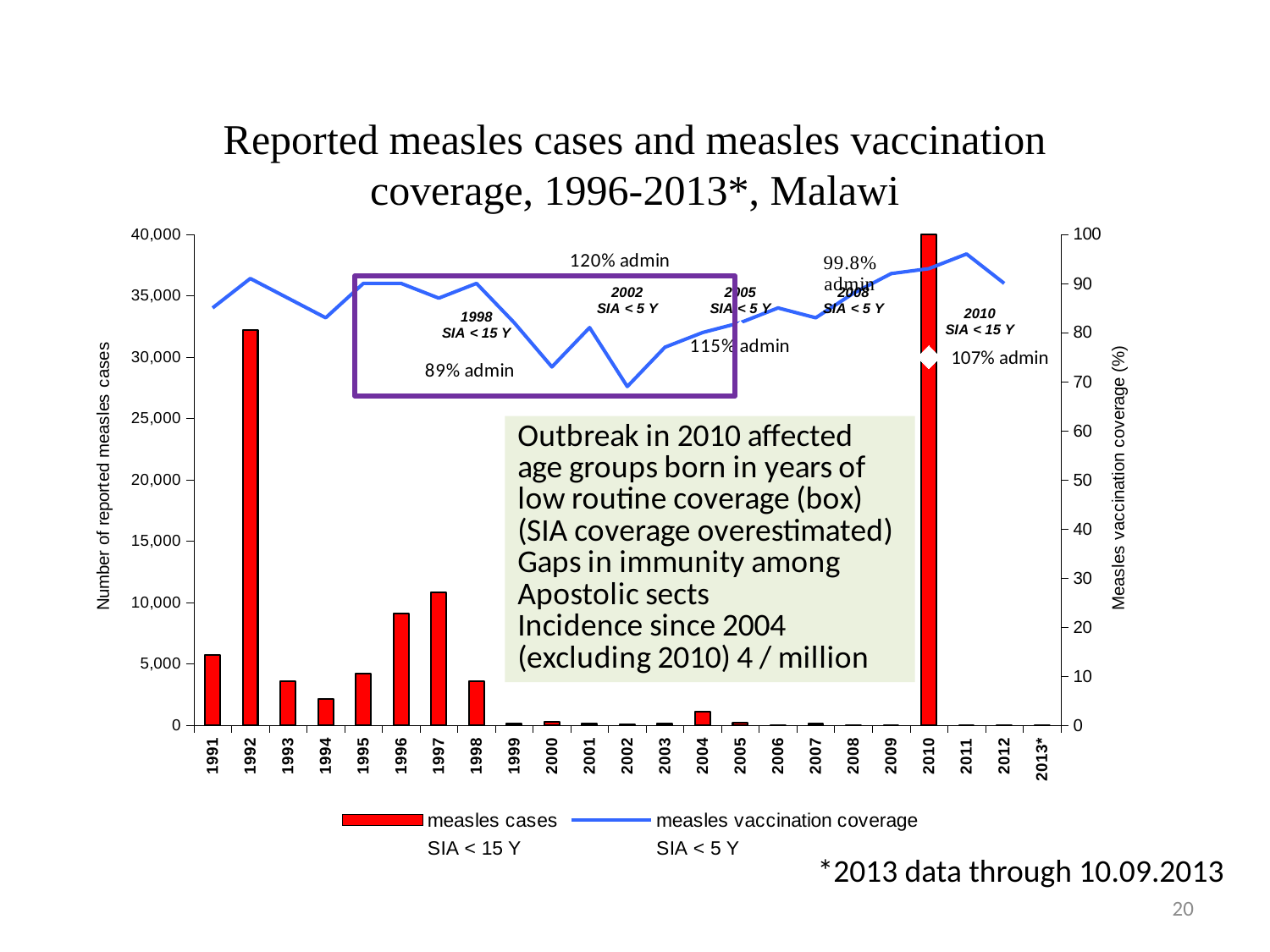
What is the label of the right-hand vertical axis? Measles vaccination coverage (%) What is the title of the chart? Reported measles cases and measles vaccination coverage, 1996-2013*, Malawi Is the number of reported measles cases in 1996 greater or less than 10,000? less Is the number of reported measles cases in 1992 greater or less than 30,000? greater In which year does the measles vaccination coverage line reach its lowest point? 2002 What kind of chart is shown on the slide? A combined bar and line chart Which year had more reported measles cases, 1992 or 1997? 1992 Is the measles vaccination coverage in 2002 greater or less than 80%? less How many years are shown along the x axis of the chart? 23 How many data series does the chart legend list? 4 Which year has the highest bar for measles cases? 2010